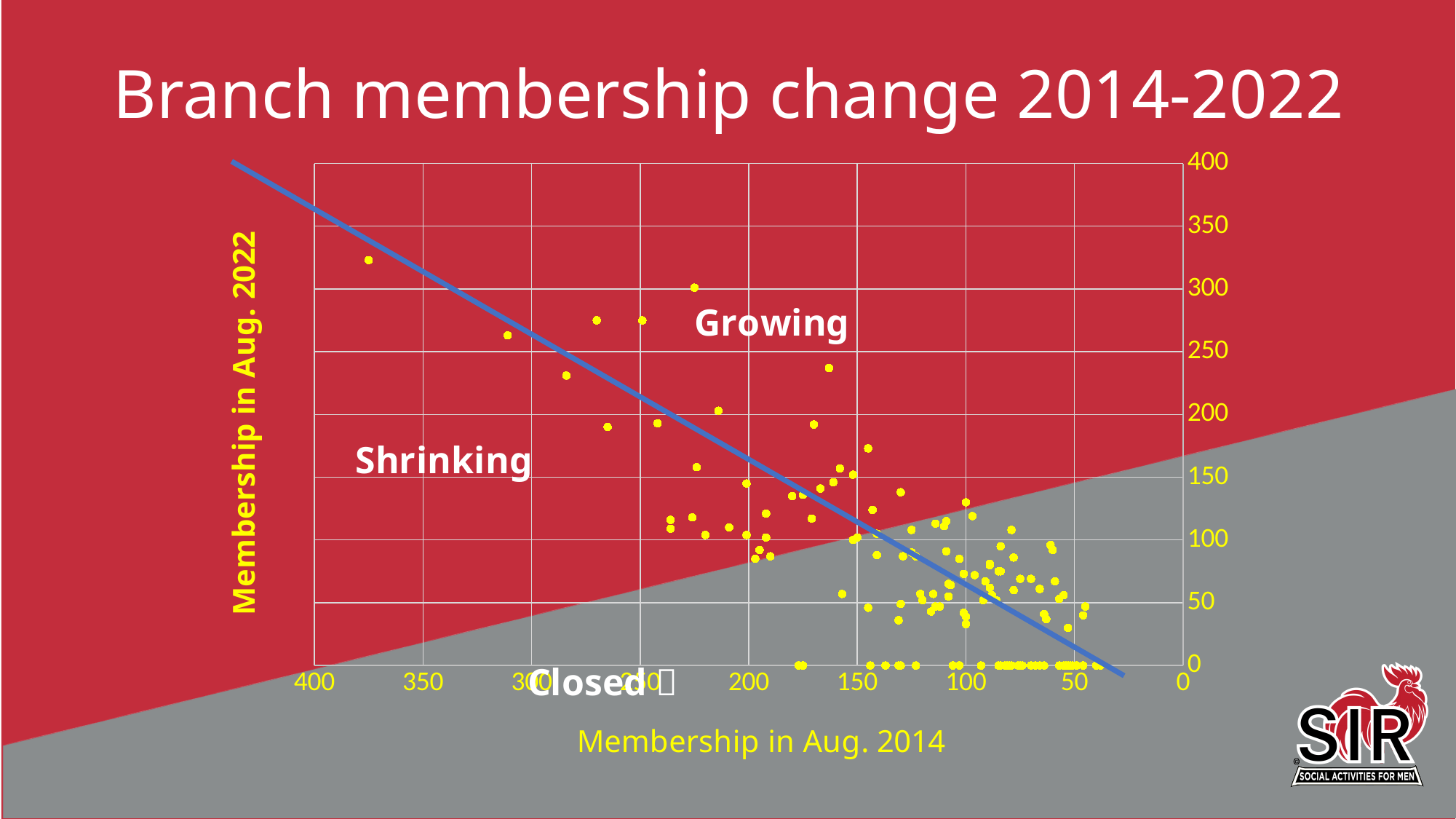
What is the title of the vertical axis of the chart? Membership in Aug. 2022 Moving from left to right along the x axis, do the plotted points generally rise or fall? fall Is the 2014 membership of the leftmost point on the chart greater or less than 350? greater Is the 2022 membership of the branch with the largest 2014 membership (the leftmost point) greater or less than 300? greater What is the title of the chart on the slide? Branch membership change 2014-2022 What 2022 membership value do the points labelled "Closed" along the bottom of the chart have? 0 What kind of chart is shown on the slide? scatter chart